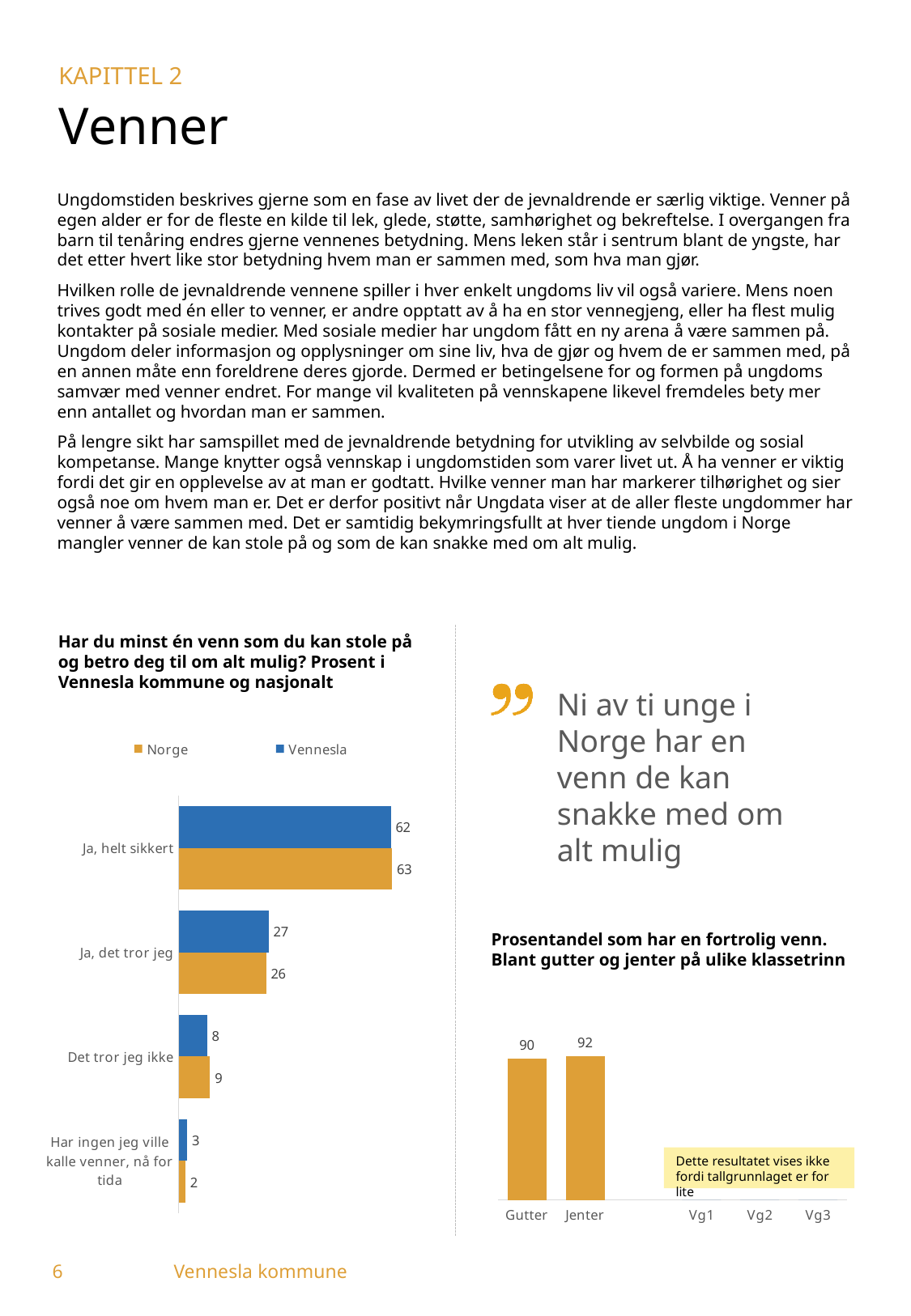
In the chart 'Prosentandel som har en fortrolig venn', which is larger, Gutter or Jenter? Jenter In the chart 'Har du minst én venn som du kan stole på og betro deg til om alt mulig?', what is the value for Norge for 'Har ingen jeg ville kalle venner, nå for tida'? 2 In the chart 'Har du minst én venn som du kan stole på og betro deg til om alt mulig?', how many series does the legend list? 2 In the chart 'Prosentandel som har en fortrolig venn', what is the value for Jenter? 92 In the chart 'Har du minst én venn som du kan stole på og betro deg til om alt mulig?', which category has the highest value for Vennesla? Ja, helt sikkert In the chart 'Har du minst én venn som du kan stole på og betro deg til om alt mulig?', how many categories are shown? 4 In the chart 'Har du minst én venn som du kan stole på og betro deg til om alt mulig?', what is the difference between the Vennesla and Norge values for 'Det tror jeg ikke'? 1 In the chart 'Prosentandel som har en fortrolig venn', what is the difference between Jenter and Gutter? 2 In the chart 'Har du minst én venn som du kan stole på og betro deg til om alt mulig?', what is the value for Norge for 'Ja, det tror jeg'? 26 What kind of chart is 'Har du minst én venn som du kan stole på og betro deg til om alt mulig?'? Bar chart In the chart 'Har du minst én venn som du kan stole på og betro deg til om alt mulig?', what is the value for Vennesla for 'Ja, helt sikkert'? 62 In the chart 'Har du minst én venn som du kan stole på og betro deg til om alt mulig?', which category has the lowest value for Norge? Har ingen jeg ville kalle venner, nå for tida